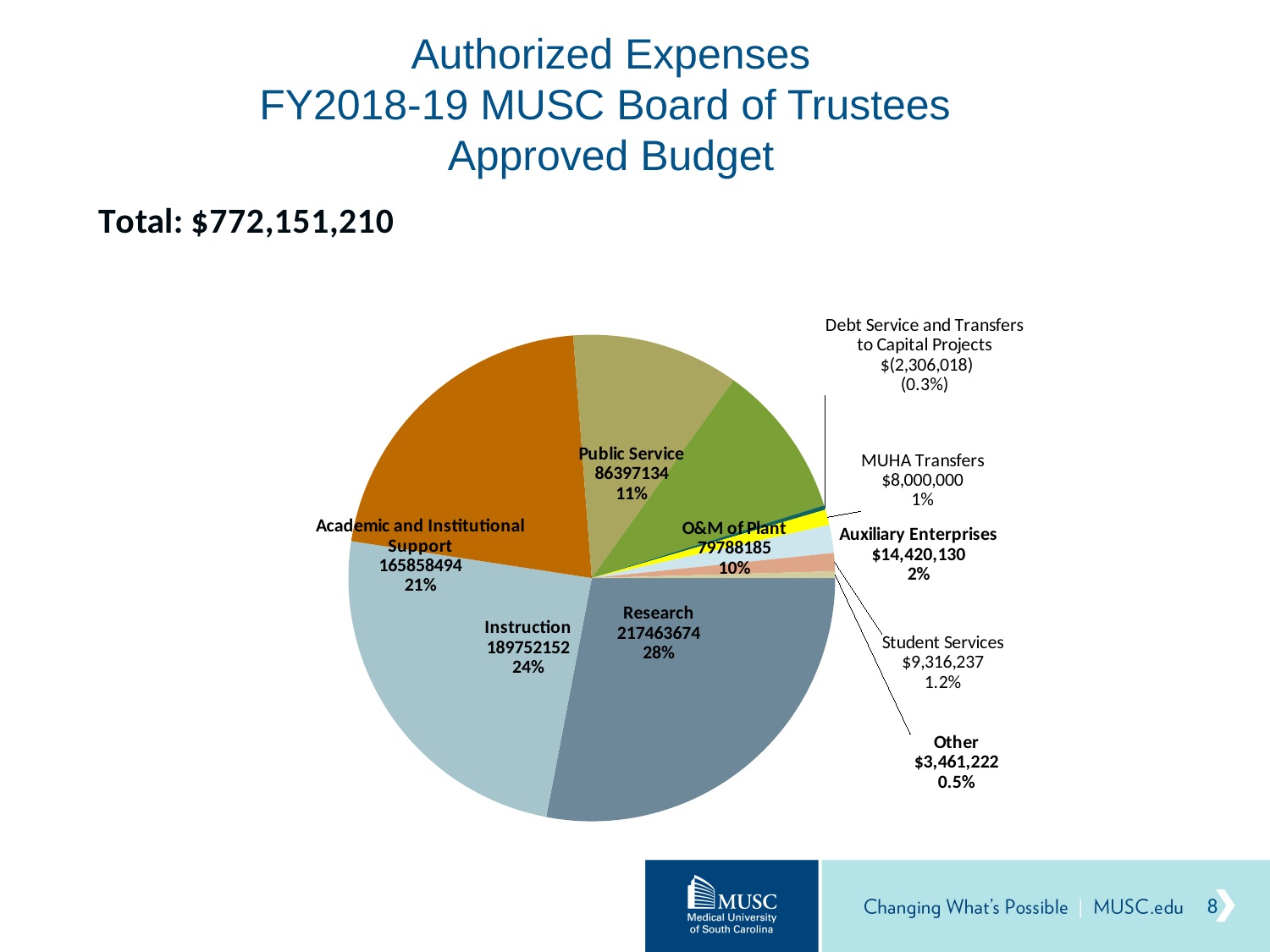
What is the difference between the values for Auxiliary Enterprises and MUHA Transfers? $6,420,130 What is the value for Student Services? $9,316,237 What share of the pie does Instruction represent? 24% What share of the pie does Academic and Institutional Support represent? 21% Which is larger, the value for Public Service or the value for O&M of Plant? Public Service What is the value for Auxiliary Enterprises? $14,420,130 What is the value for Research in the pie chart? 217463674 What is the difference between the values for Research and Instruction? 27711522 Which category has the largest share of the pie? Research What type of chart is shown on the slide? Pie chart Which category is shown with a negative value in the chart? Debt Service and Transfers to Capital Projects How many categories are shown in the pie chart? 10